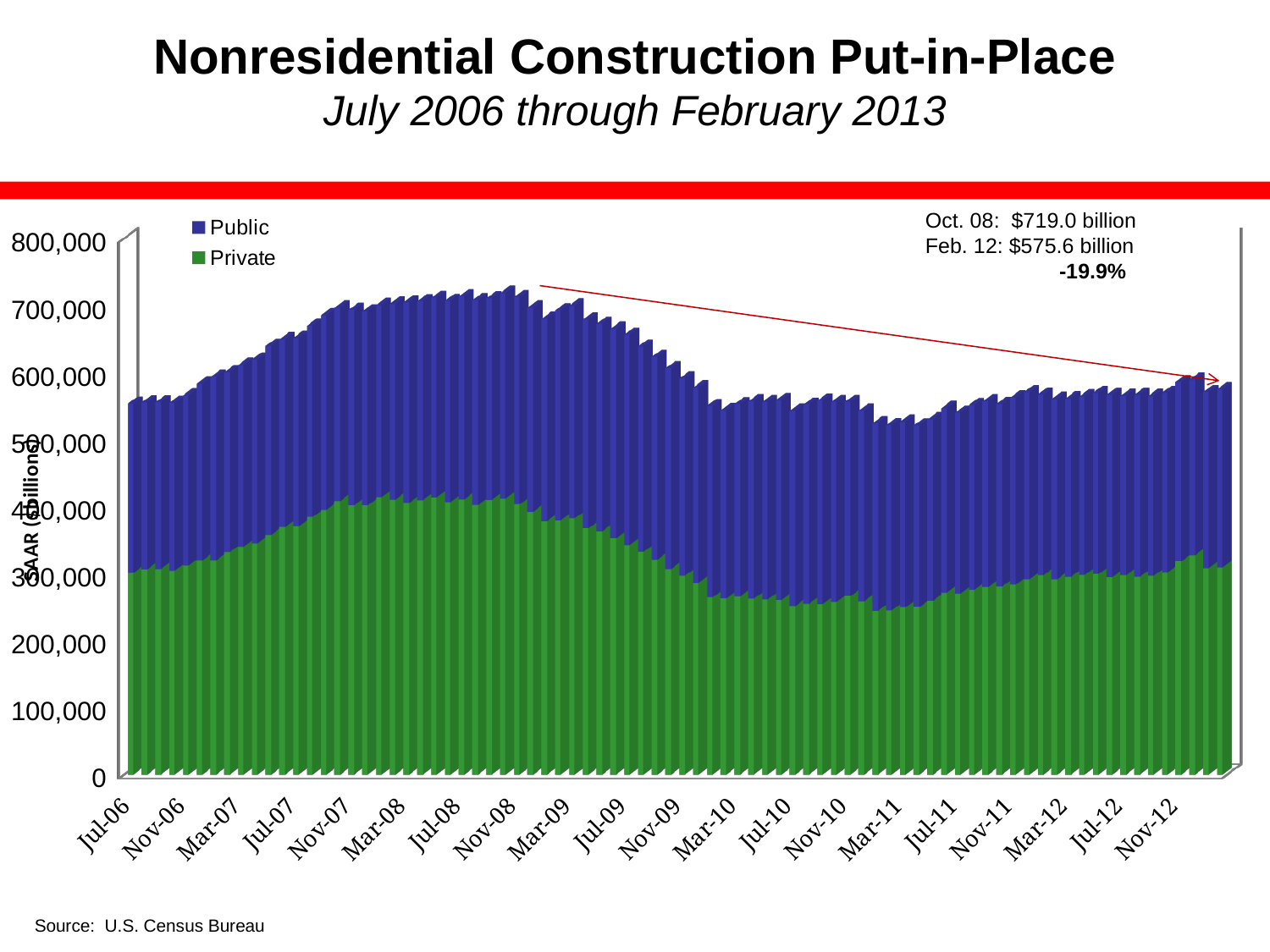
What is the source cited for the chart data? U.S. Census Bureau According to the annotation, what was the value for Oct. 08? $719.0 billion What is the difference between the Oct. 08 value and the Feb. 12 value shown in the annotation? $143.4 billion Does the total construction put-in-place rise or fall from Nov-08 to Mar-11? fall What percentage change is shown between Oct. 08 and Feb. 12? -19.9% What kind of chart is shown on the slide? Stacked bar chart According to the annotation, what was the value for Feb. 12? $575.6 billion How many series does the legend list? 2 Which two series are shown in the legend? Public and Private Is the total (Public plus Private) for Jul-06 greater or less than 600,000? less Is the Private value for Mar-11 greater or less than 300,000? less